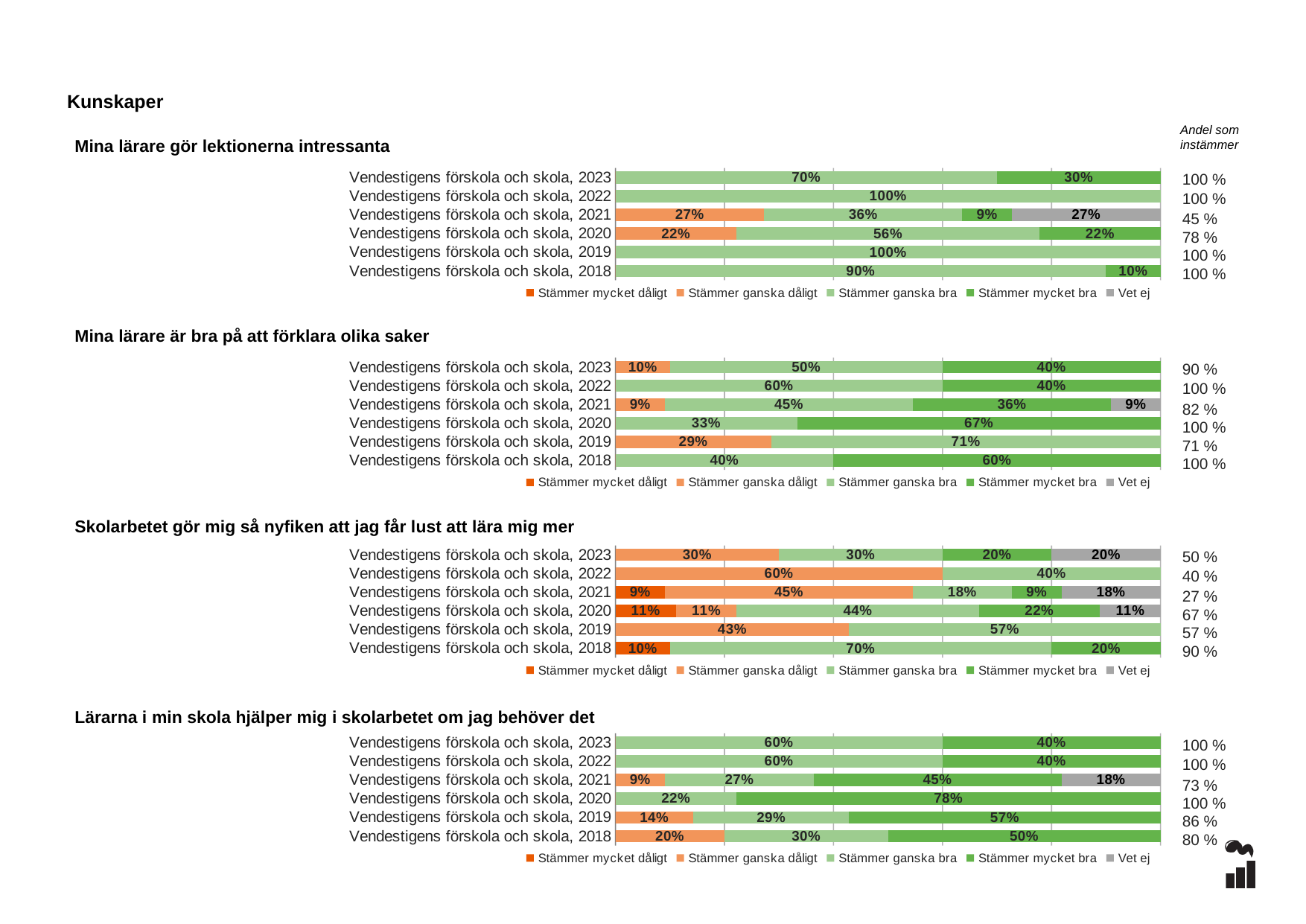
In the chart 'Mina lärare är bra på att förklara olika saker', how many series does the legend list? 5 In the chart 'Mina lärare är bra på att förklara olika saker', what is the difference between the 'Stämmer ganska bra' values for 2019 and 2018? 31% In the chart 'Mina lärare gör lektionerna intressanta', what is the 'Stämmer ganska bra' value for Vendestigens förskola och skola, 2020? 56% In the chart 'Skolarbetet gör mig så nyfiken att jag får lust att lära mig mer', how many bars (years) are shown? 6 In the chart 'Mina lärare är bra på att förklara olika saker', what is the 'Stämmer mycket bra' value for Vendestigens förskola och skola, 2020? 67% In the chart 'Skolarbetet gör mig så nyfiken att jag får lust att lära mig mer', which year has the highest 'Andel som instämmer'? 2018 In the chart 'Mina lärare gör lektionerna intressanta', what is the 'Vet ej' value for Vendestigens förskola och skola, 2021? 27% In the chart 'Lärarna i min skola hjälper mig i skolarbetet om jag behöver det', which is larger: the 'Stämmer mycket bra' value for 2020 or for 2018? 2020 In the chart 'Lärarna i min skola hjälper mig i skolarbetet om jag behöver det', what is the 'Stämmer mycket bra' value for Vendestigens förskola och skola, 2019? 57% What kind of chart is used for 'Lärarna i min skola hjälper mig i skolarbetet om jag behöver det'? Stacked bar chart In the chart 'Skolarbetet gör mig så nyfiken att jag får lust att lära mig mer', what is the 'Stämmer ganska dåligt' value for Vendestigens förskola och skola, 2022? 60% In the chart 'Mina lärare gör lektionerna intressanta', which year has the lowest 'Andel som instämmer'? 2021